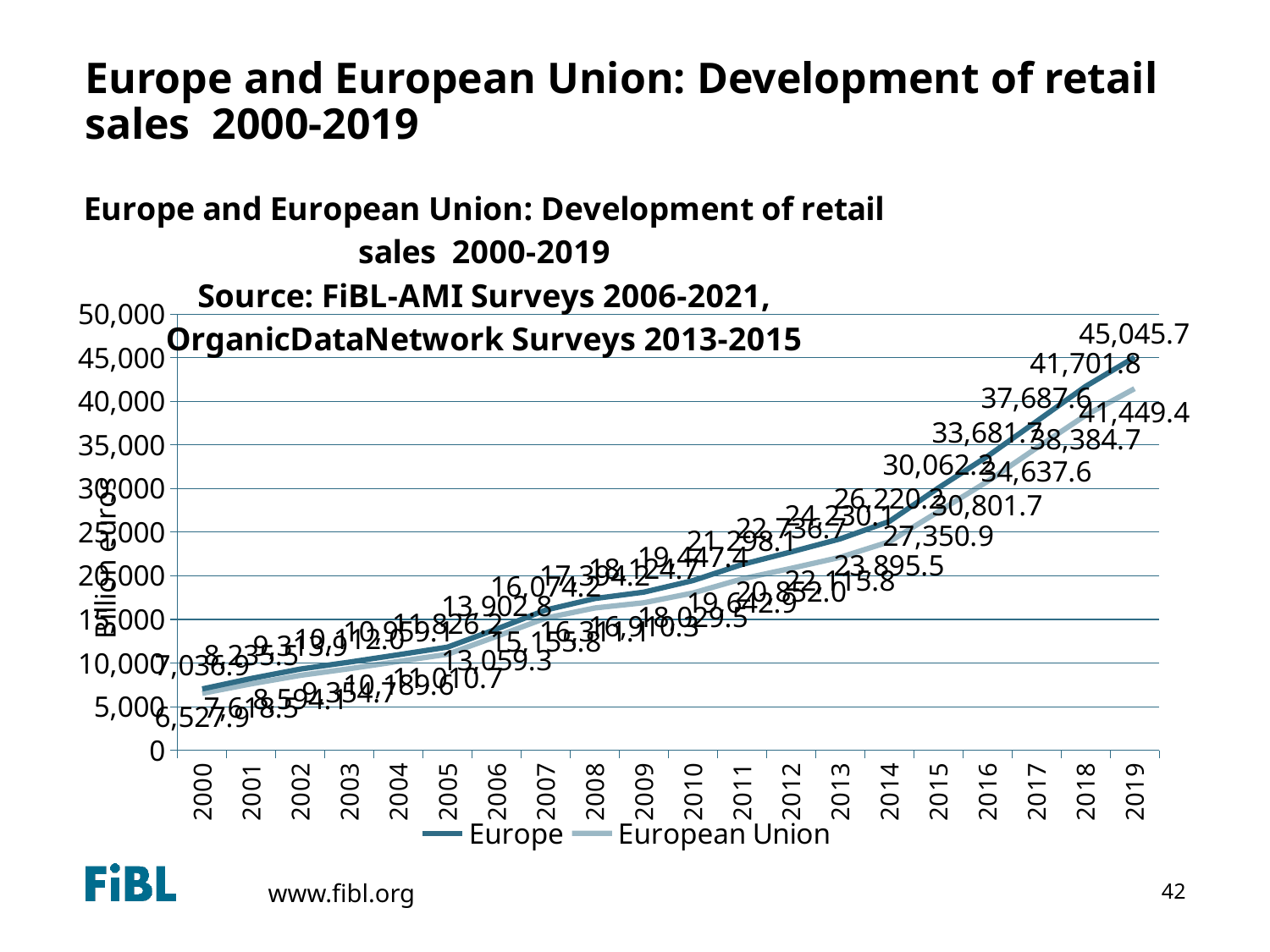
Is the value for the European Union in 2010 greater or less than 20,000? less What is the value for the European Union in 2017? 34,637.6 What kind of chart is shown on the slide? line chart Do the values for Europe rise or fall from 2000 to 2019? rise How many series does the legend list? 2 What is the retail sales value for the European Union in 2019? 41,449.4 What is the difference between the Europe and European Union values in 2019? 3,596.3 What is the retail sales value for Europe in 2019? 45,045.7 What is the value for Europe in 2018? 41,701.8 In 2016, which series has the larger value, Europe or European Union? Europe What is the value for Europe in 2000? 7,036.9 In which year does the Europe series reach its highest value? 2019